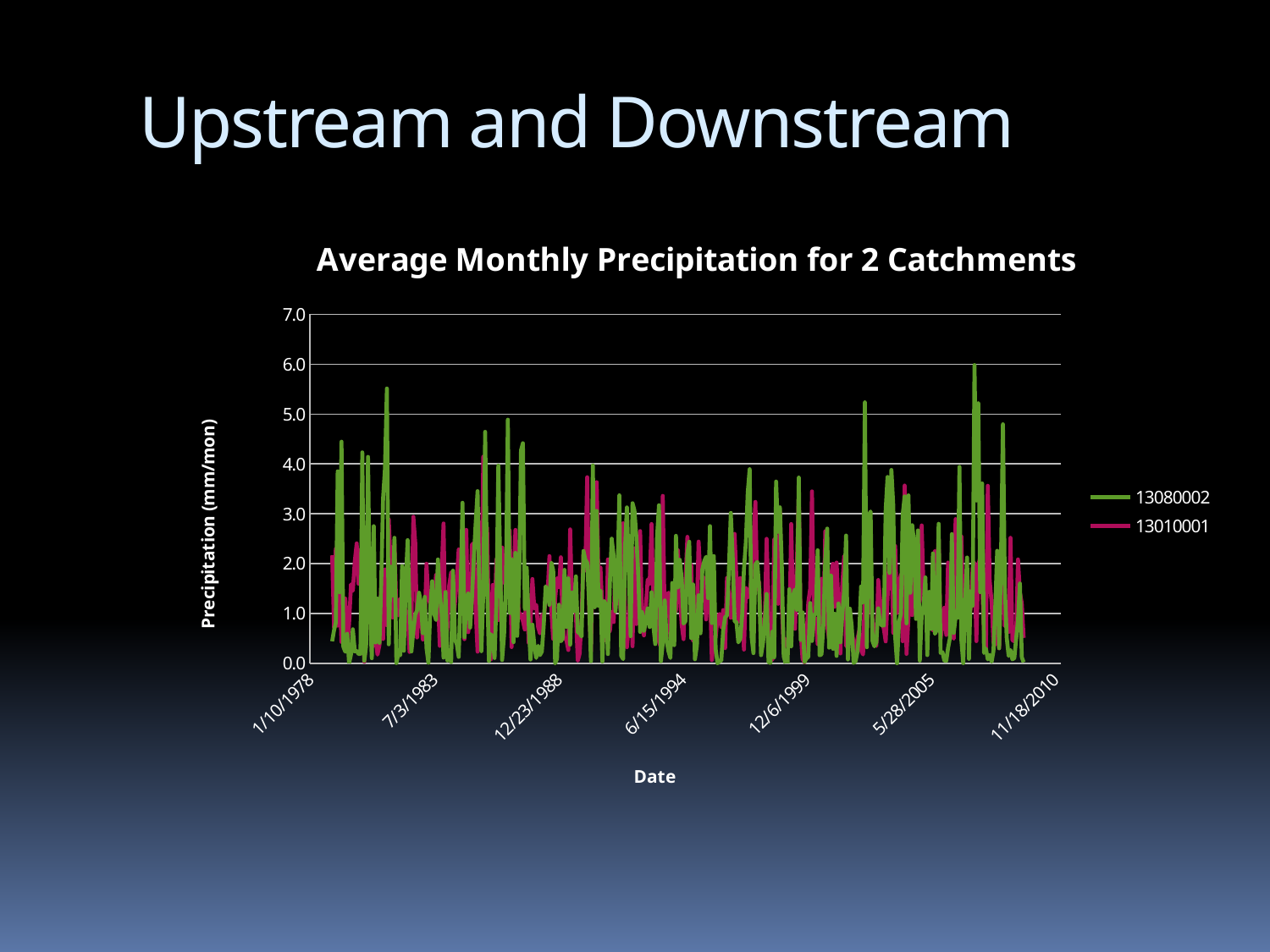
Is the highest value of series 13080002 greater or less than 7.0? less Which series reaches the highest peak value on the chart, 13080002 or 13010001? 13080002 What is the title of the chart? Average Monthly Precipitation for 2 Catchments How many series does the legend list? 2 How many date labels are shown on the horizontal axis? 7 What is the last date label on the horizontal axis? 11/18/2010 What is the first date label on the horizontal axis? 1/10/1978 What kind of chart is shown on the slide? Line chart What is the highest value shown on the vertical axis? 7.0 What is the label of the vertical axis? Precipitation (mm/mon) Is the highest value of series 13080002 greater or less than 5.0? greater